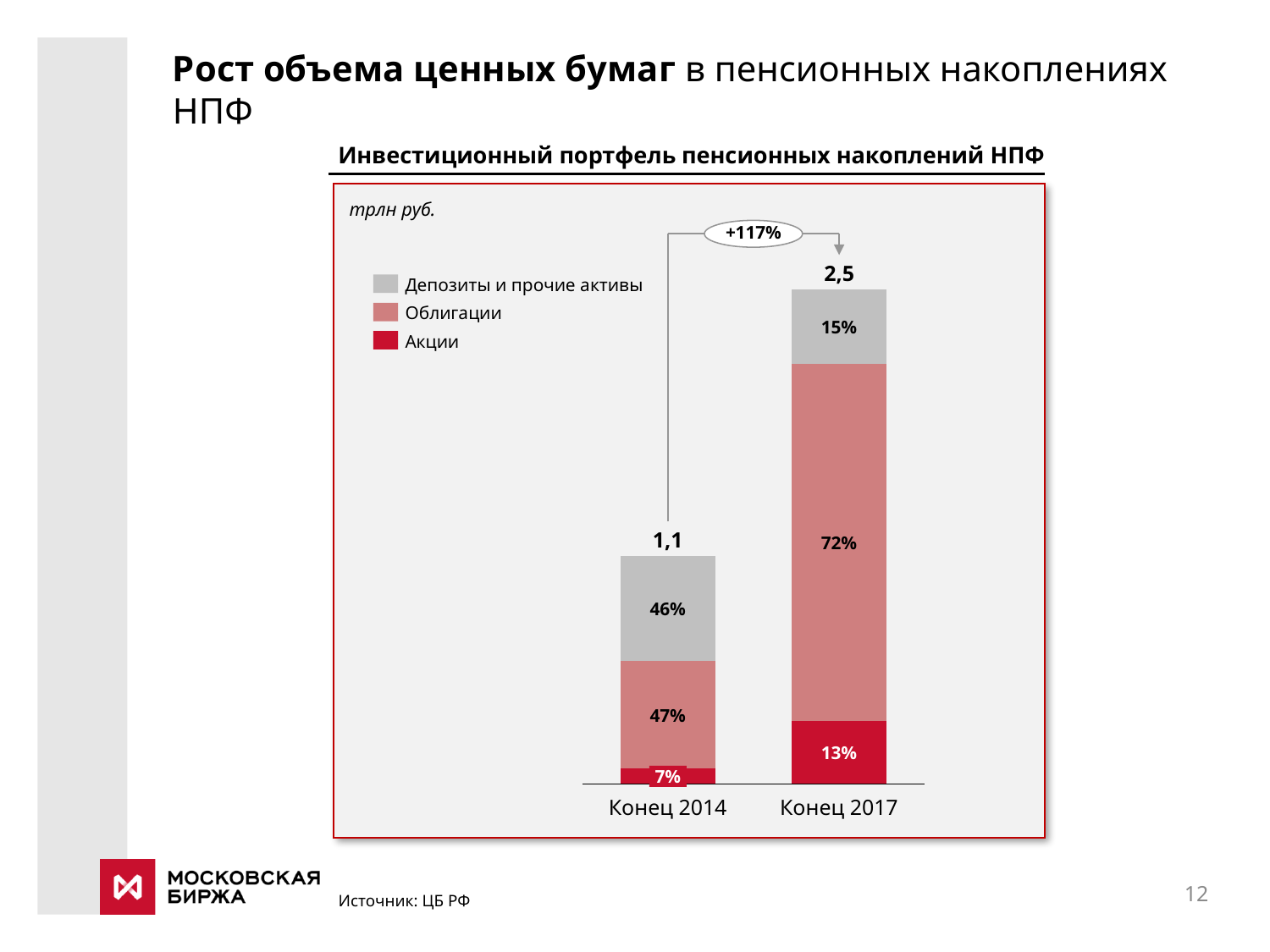
What unit is stated for the chart values? трлн руб. What share of the portfolio do Депозиты и прочие активы make up at Конец 2017? 15% How many series does the legend list? 3 What share of the portfolio do Акции make up at Конец 2017? 13% What is the total value of the stacked bar for Конец 2017? 2,5 By how many percentage points did the share of Облигации change from Конец 2014 to Конец 2017? 25 What is the total value of the stacked bar for Конец 2014? 1,1 What share of the portfolio do Облигации make up at Конец 2014? 47% Which period has the larger total portfolio value, Конец 2014 or Конец 2017? Конец 2017 What percentage growth is shown between Конец 2014 and Конец 2017? +117% What kind of chart is shown on the slide? Stacked bar chart What share of the portfolio do Акции make up at Конец 2014? 7%